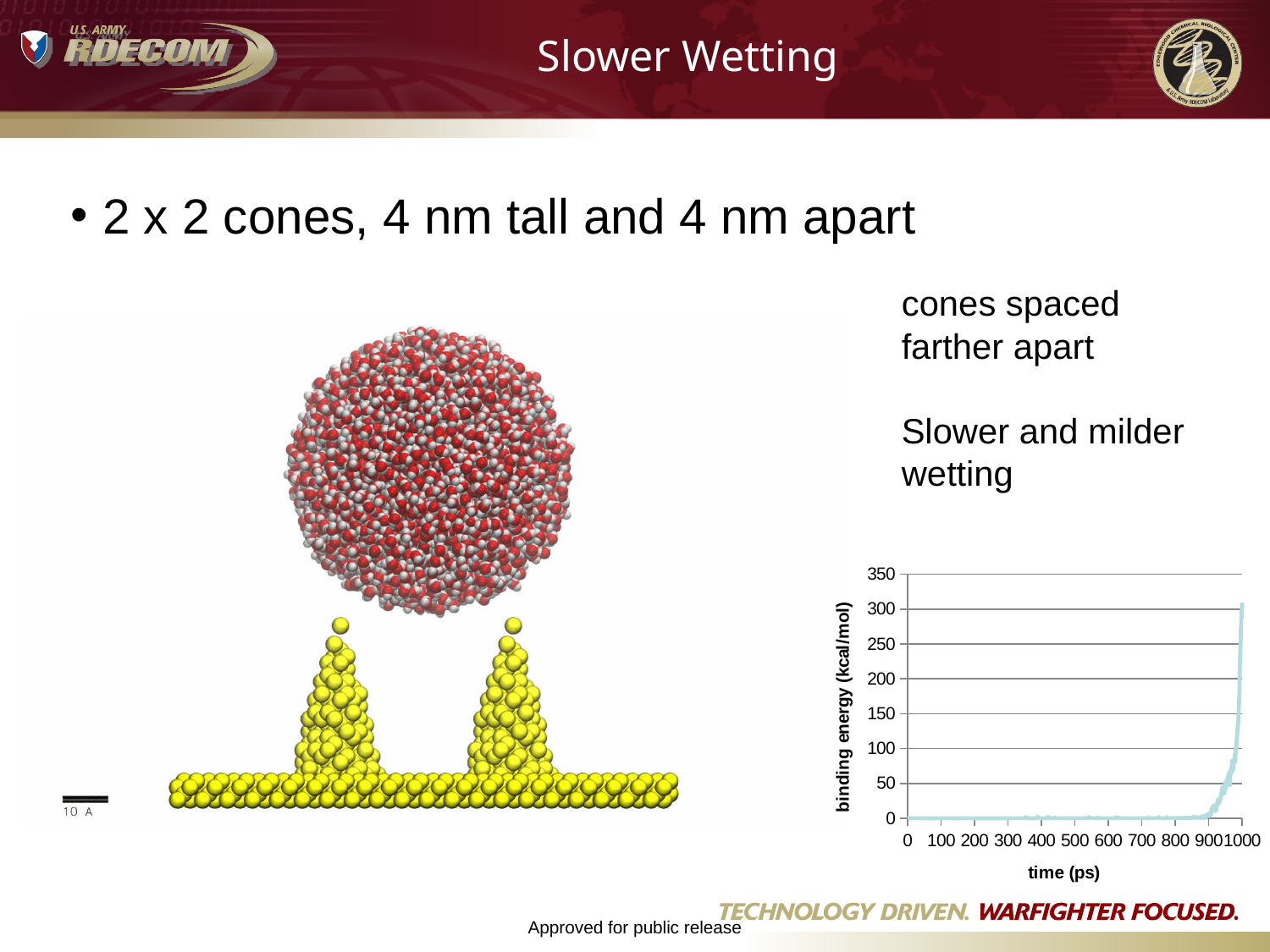
Is the binding energy at 950 ps greater or less than 200 kcal/mol? less Is the binding energy at 800 ps greater or less than 100 kcal/mol? less Does the binding energy rise or fall toward the end of the time axis? rise Is the binding energy at 100 ps greater or less than 50 kcal/mol? less Is the binding energy larger at 1000 ps or at 200 ps? 1000 ps What kind of chart is shown at the bottom right of the slide? line chart What is the label of the x axis of the chart? time (ps) What is the label of the y axis of the chart? binding energy (kcal/mol)